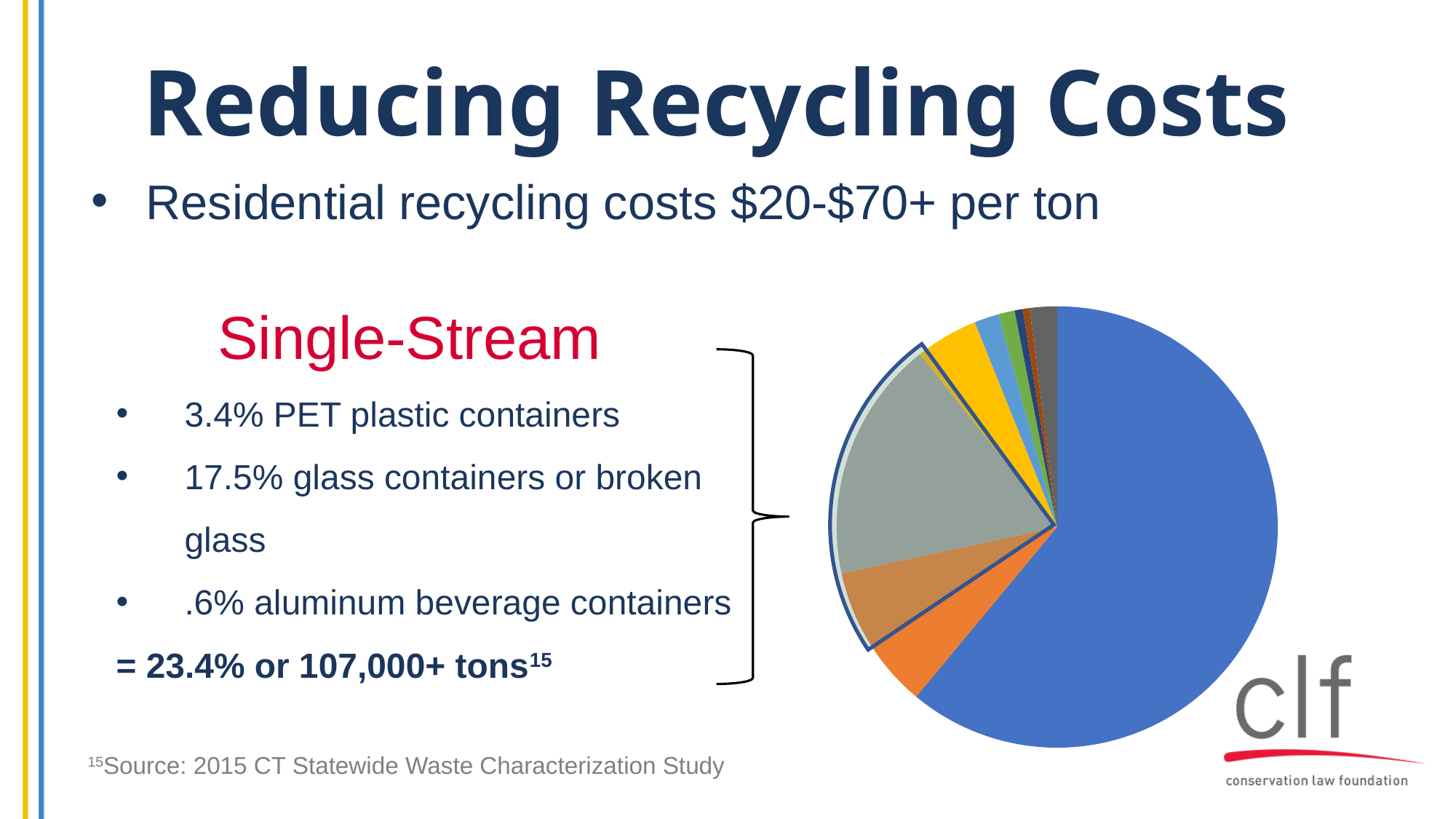
What kind of chart is shown on the slide? pie chart What percentage of the pie is aluminum beverage containers, according to the slide? .6% Does the pie chart have a legend? no How many tons does the 23.4% single-stream share correspond to, according to the slide? 107,000+ tons Which is larger: the share for glass containers or broken glass, or the share for PET plastic containers? glass containers or broken glass What percentage of the pie is glass containers or broken glass, according to the slide? 17.5% Of the three single-stream categories listed, which has the smallest share? aluminum beverage containers What combined share of the pie do the three outlined single-stream slices represent, according to the slide? 23.4% What is the difference between the share for glass containers or broken glass and the share for PET plastic containers? 14.1% What percentage of the pie is PET plastic containers, according to the slide? 3.4% What colour is the largest slice of the pie chart? blue Of the three single-stream categories listed, which has the largest share? glass containers or broken glass